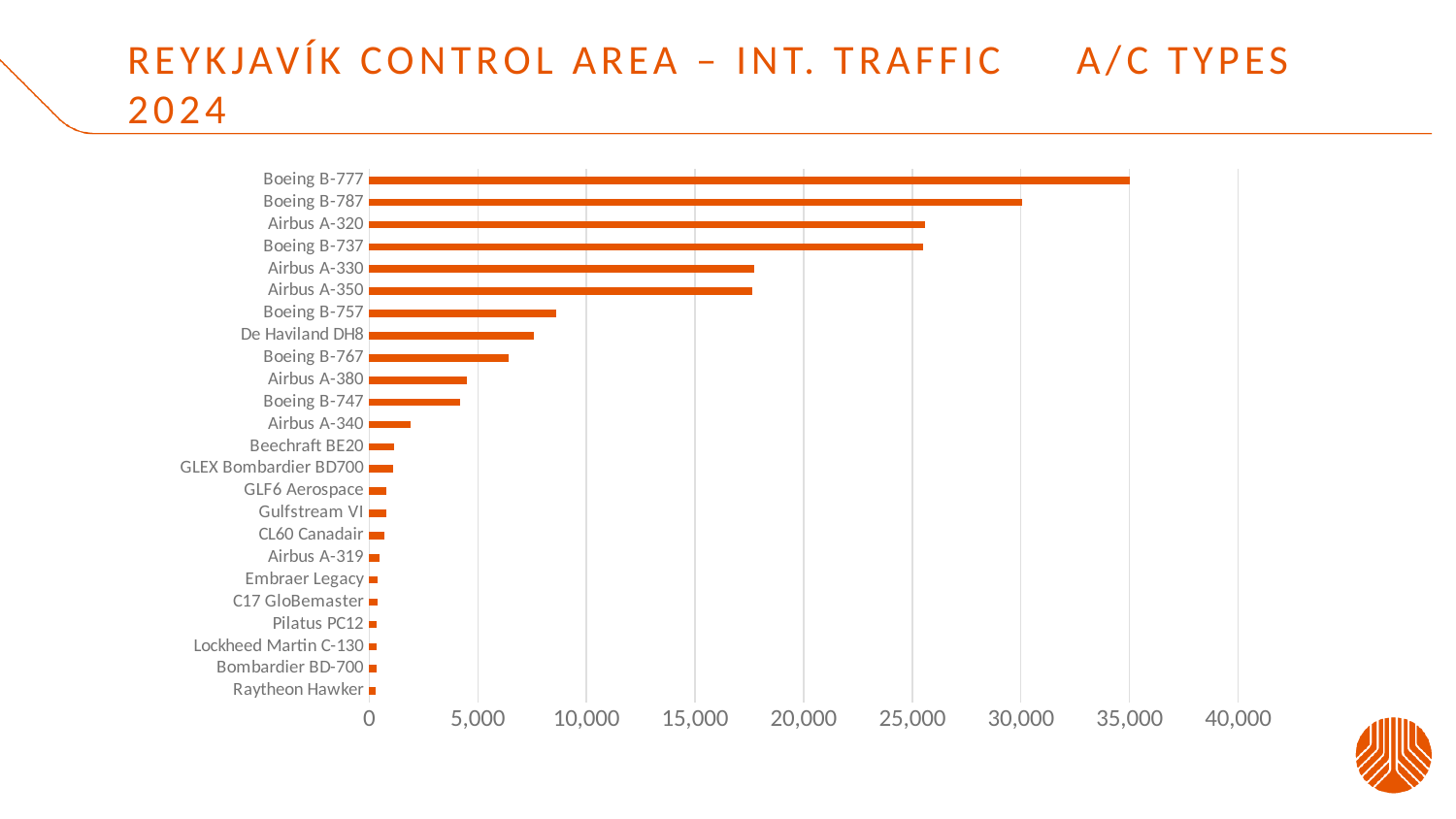
Is the value for Boeing B-777 greater or less than 30,000? greater Do the bar values increase or decrease going from the top of the chart to the bottom? decrease Is the value for Boeing B-757 greater or less than 10,000? less Which has a larger value, Boeing B-767 or Airbus A-380? Boeing B-767 How many aircraft types are listed on the chart? 24 What colour are the bars on the chart? orange What kind of chart is shown on the slide? bar chart Is the value for Airbus A-380 greater or less than 5,000? less Which aircraft type has the highest value on the chart? Boeing B-777 Which has a larger value, Boeing B-777 or Boeing B-787? Boeing B-777